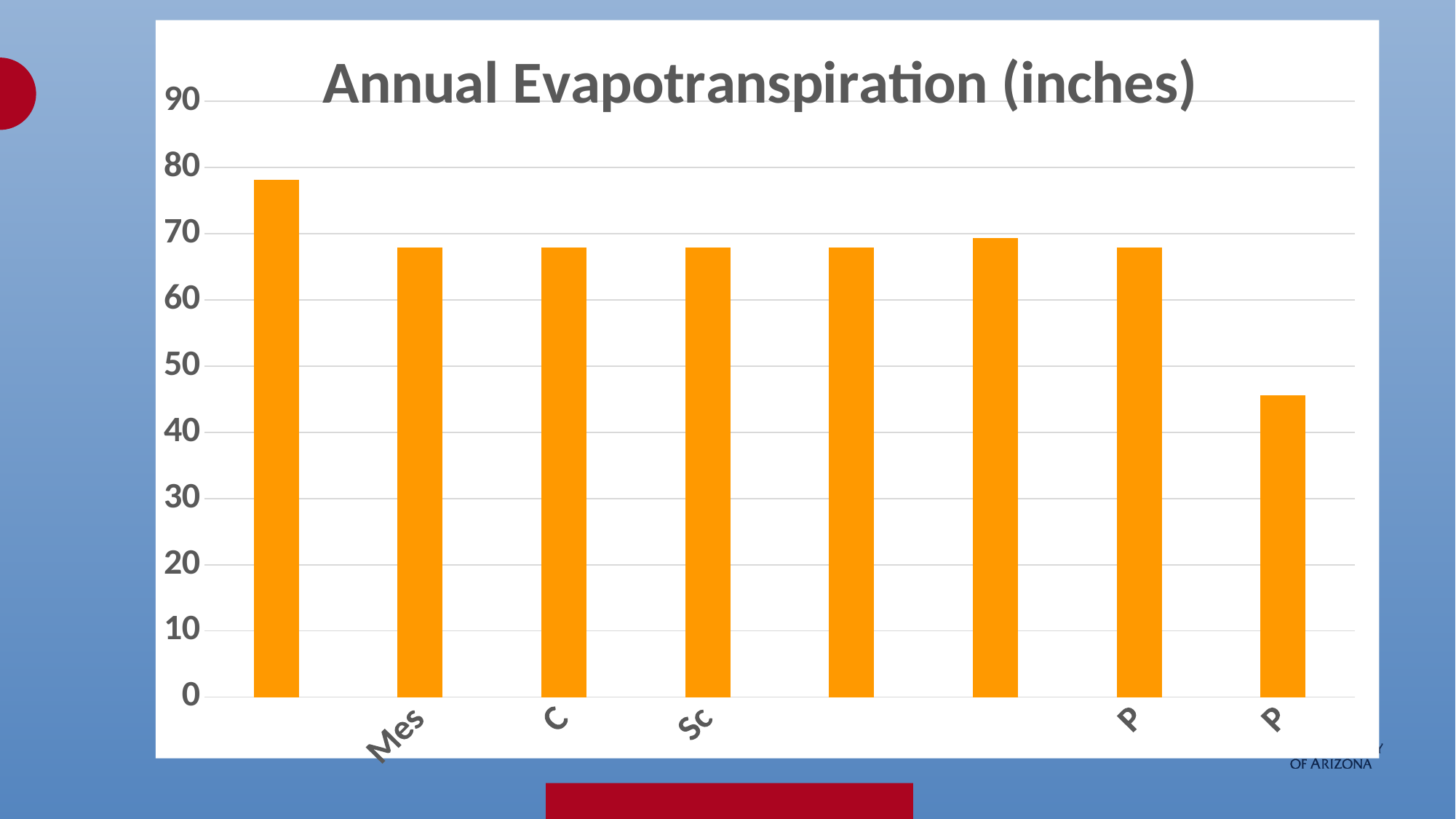
Is the value for Mes greater or less than 70? less What colour are the bars in the chart? orange Is the value for Sc greater or less than 70? less Which bar is the tallest, the leftmost bar or the bar for Mes? the leftmost bar What kind of chart is shown on the slide? bar chart How many bars are plotted in the chart? 8 Is the value of the rightmost bar greater or less than 50? less Which bar is the tallest in the chart, the leftmost or the rightmost? the leftmost Which bar is the shortest, the leftmost bar or the rightmost bar? the rightmost bar What is the title of the chart? Annual Evapotranspiration (inches)